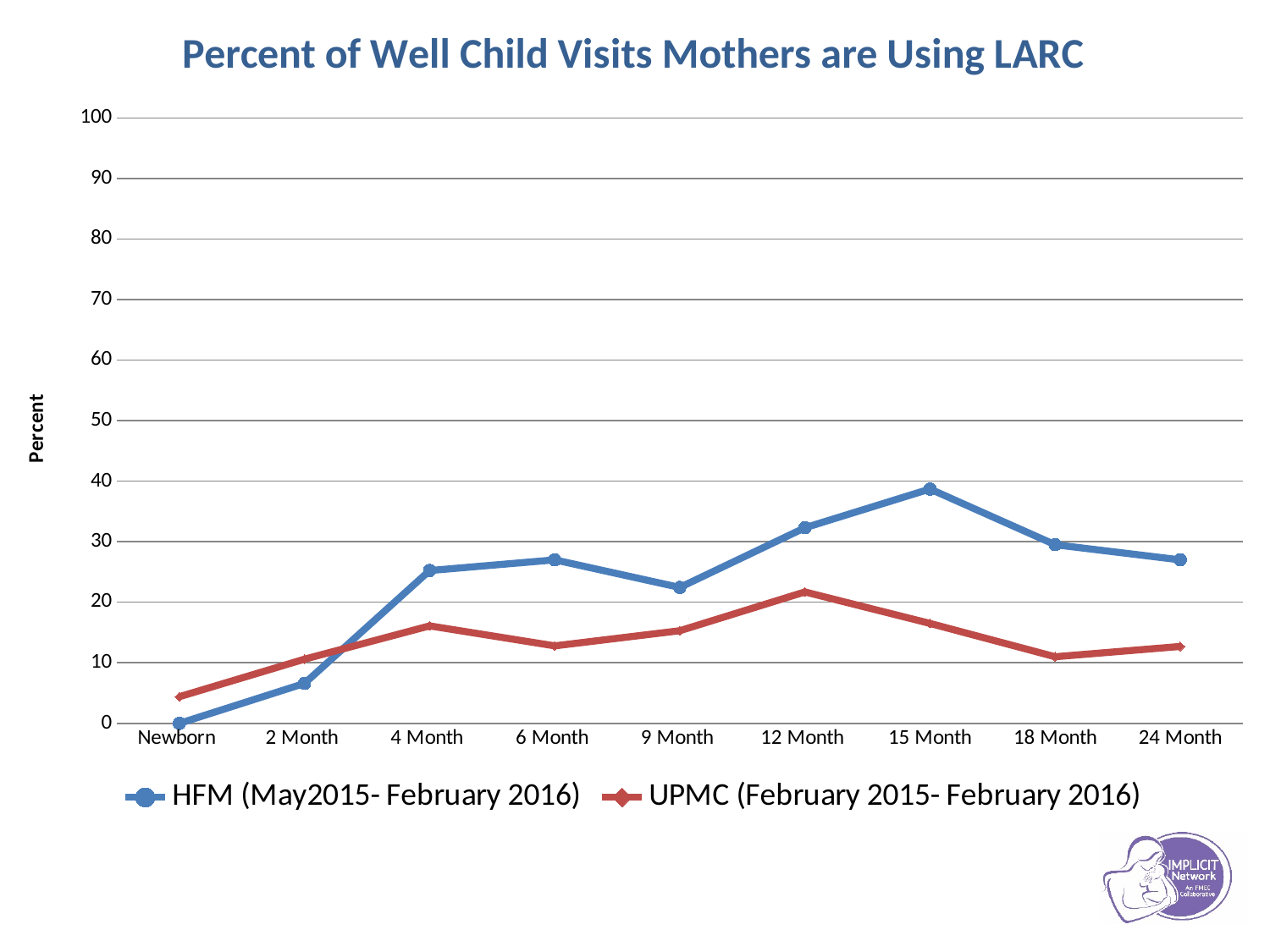
At which visit is the UPMC (February 2015- February 2016) series highest? 12 Month How many series does the legend list? 2 Is the UPMC value at the 18 Month visit greater or less than 20? less What kind of chart is shown on the slide? line chart At the 4 Month visit, which series has the larger value, HFM or UPMC? HFM At which visit is the UPMC (February 2015- February 2016) series lowest? Newborn At the Newborn visit, which series has the larger value, HFM or UPMC? UPMC At which visit is the HFM (May2015- February 2016) series highest? 15 Month Is the HFM value at the 15 Month visit greater or less than 30? greater At which visit is the HFM (May2015- February 2016) series lowest? Newborn What is the title of the chart? Percent of Well Child Visits Mothers are Using LARC How many visit categories are shown on the x axis? 9